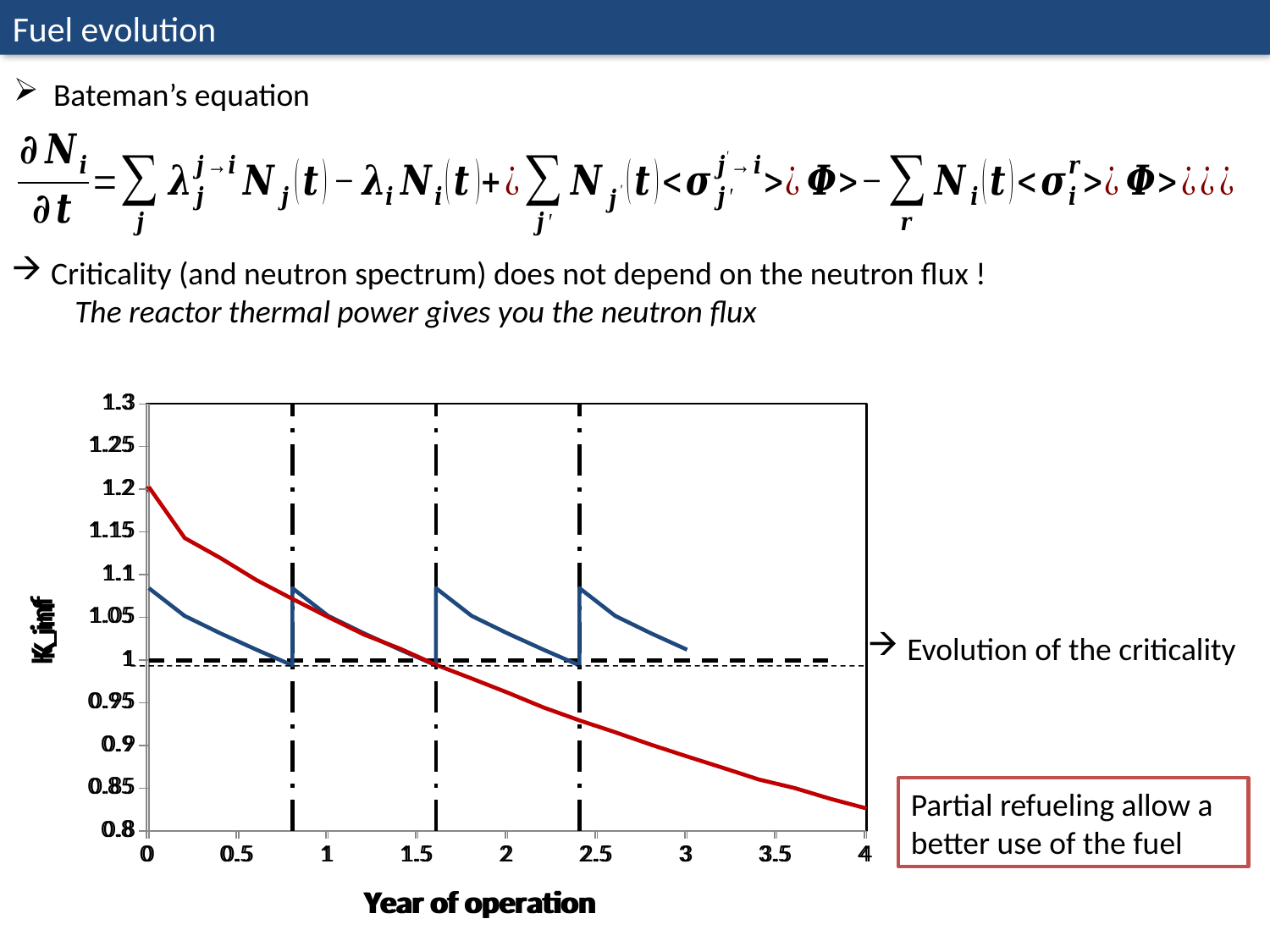
What is the title of the x axis of the chart? Year of operation What is the label on the y axis of the chart? K_inf Does the red line rise or fall as the year of operation increases? fall How many vertical dash-dot lines are drawn on the chart? 3 Is the value of the red line at year 4 greater or less than 0.85? less At year 3, which line has the higher value, the red line or the blue line? the blue line Is the value of the red line at year 3 greater or less than 0.95? less Is the value of the red line at year 0 greater or less than 1.1? greater What kind of chart is shown on the slide? line chart What is the highest value shown on the y axis of the chart? 1.3 At year 0, which line has the higher value, the red line or the blue line? the red line